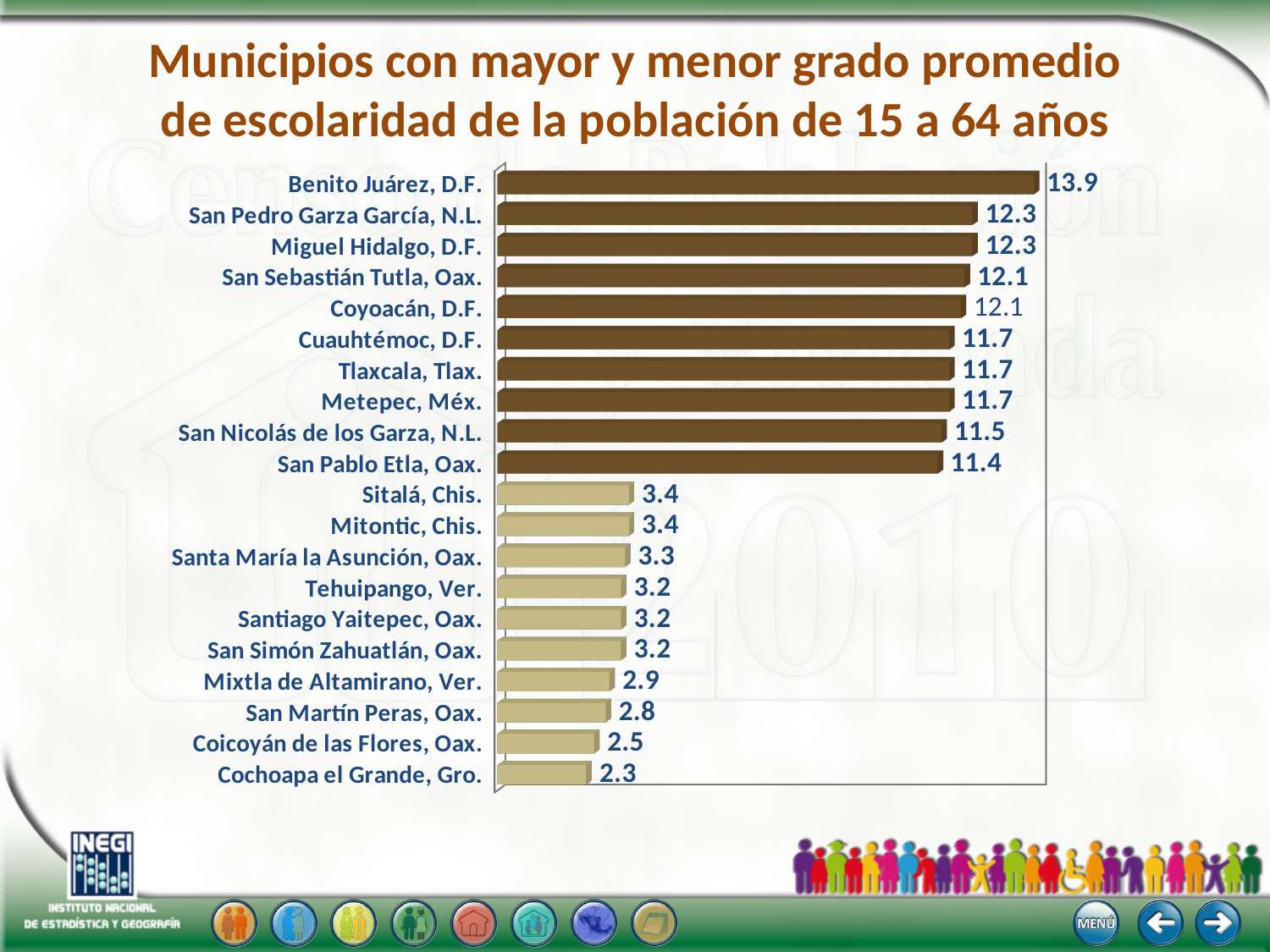
What is the average years of schooling value shown for Benito Juárez, D.F.? 13.9 Which municipality has the highest value on the chart? Benito Juárez, D.F. What value is shown for Cochoapa el Grande, Gro.? 2.3 Which has a larger value, San Martín Peras, Oax. or Coicoyán de las Flores, Oax.? San Martín Peras, Oax. Which municipality has the lowest value on the chart? Cochoapa el Grande, Gro. What is the difference between the values for San Pablo Etla, Oax. and Sitalá, Chis.? 8.0 What kind of chart is shown on the slide? Bar chart Which has a larger value, Coyoacán, D.F. or Cuauhtémoc, D.F.? Coyoacán, D.F. What value is shown for San Nicolás de los Garza, N.L.? 11.5 What value is shown for Mixtla de Altamirano, Ver.? 2.9 How many municipalities are shown on the chart? 20 What is the difference between the values for Benito Juárez, D.F. and Cochoapa el Grande, Gro.? 11.6